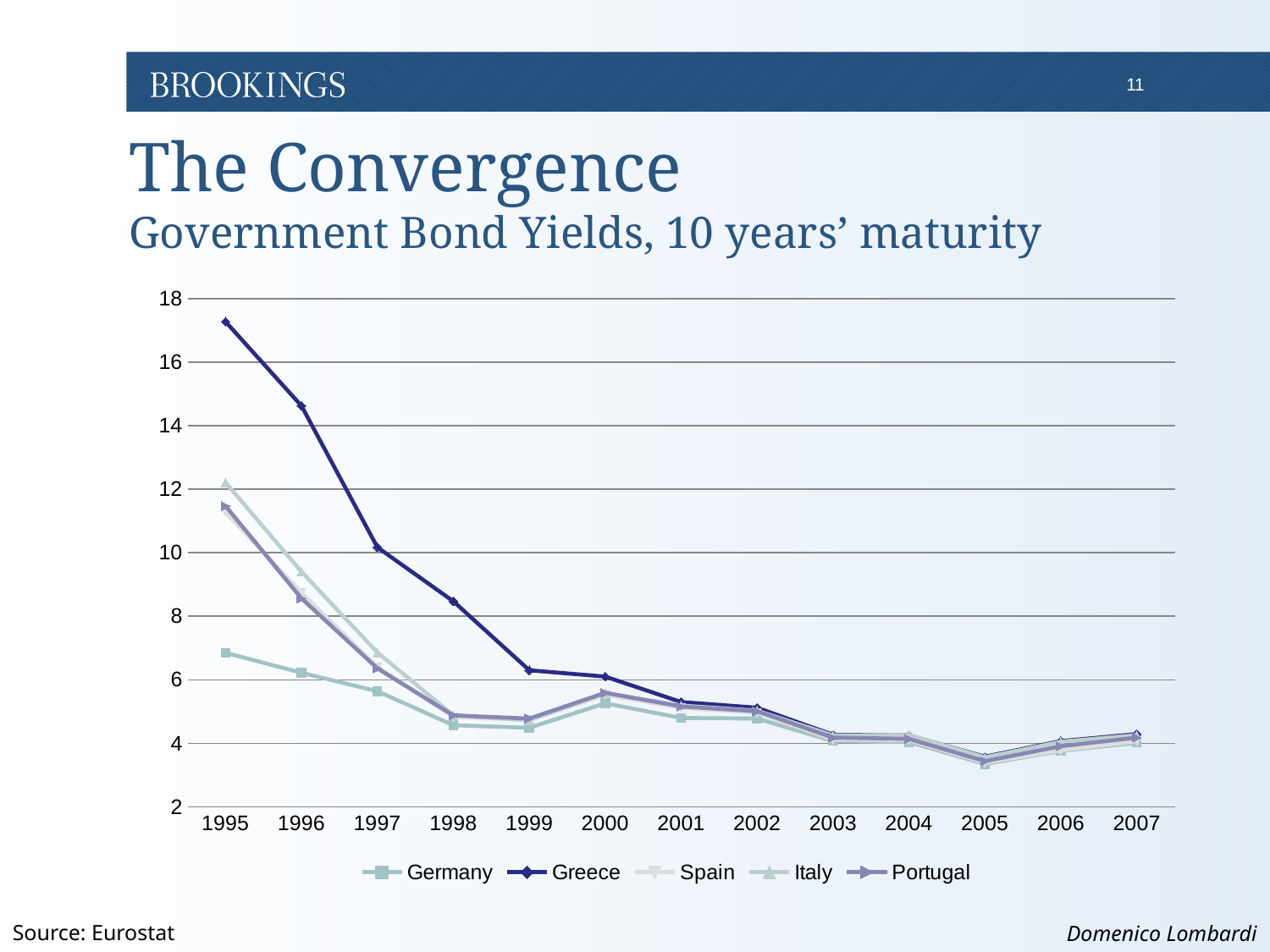
Is the value for Greece in 1995 greater or less than 16? greater How many series does the legend list? 5 Does the bond yield for Greece rise or fall from 1995 to 2005? fall Is the value for Germany in 1995 greater or less than 8? less What is the source cited for the chart data? Eurostat Which is larger in 1996, the value for Greece or the value for Germany? Greece Is the value for Greece in 1996 greater or less than 14? greater Which country had the lowest bond yield in 1995? Germany Which country had the highest bond yield in 1995? Greece What kind of chart is shown on the slide? line chart How many years are shown along the x axis? 13